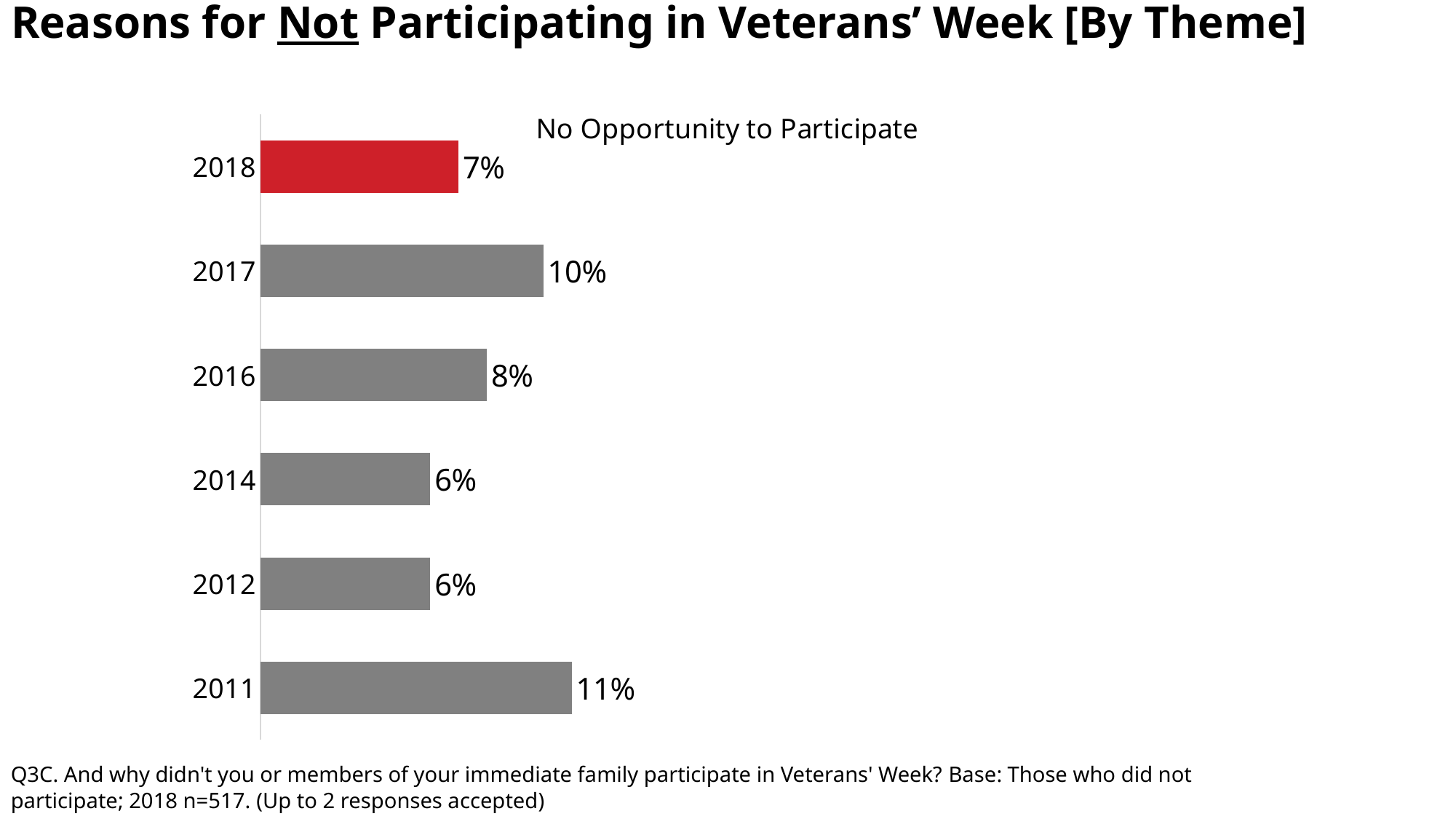
What is the difference between the 2017 and 2018 values in the 'No Opportunity to Participate' chart? 3% How many years are shown in the 'No Opportunity to Participate' chart? 6 What kind of chart is shown on the slide? Bar chart Which year has the highest value in the 'No Opportunity to Participate' chart? 2011 What is the value for 2011 in the 'No Opportunity to Participate' chart? 11% Which is larger in the 'No Opportunity to Participate' chart, the value for 2016 or the value for 2018? 2016 What is the title of the chart on the slide? No Opportunity to Participate What is the difference between the 2011 and 2014 values in the 'No Opportunity to Participate' chart? 5% Which year's bar is coloured red in the 'No Opportunity to Participate' chart? 2018 What is the value for 2018 in the 'No Opportunity to Participate' chart? 7% What is the value for 2017 in the 'No Opportunity to Participate' chart? 10% What is the value for 2016 in the 'No Opportunity to Participate' chart? 8%